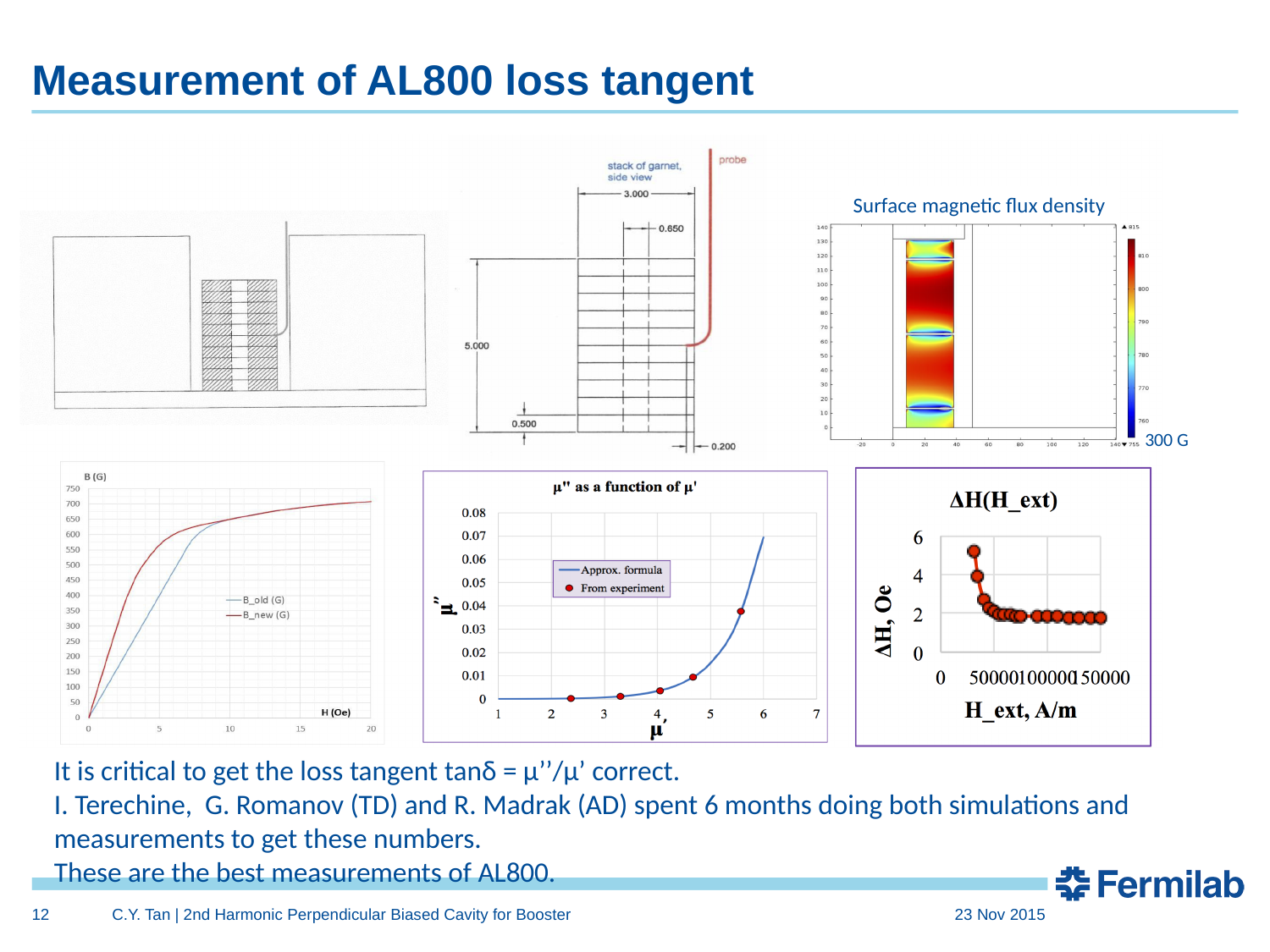
In the B (G) versus H (Oe) chart at the bottom left, what are the two legend entries? B_old (G) and B_new (G) In the chart titled "μ'' as a function of μ'", how many "From experiment" data points are plotted? 5 In the B (G) versus H (Oe) chart at the bottom left, at H = 5 Oe, is the B_old value greater or less than 500? less In the B (G) versus H (Oe) chart at the bottom left, does B rise or fall as H increases? rise In the chart titled "ΔH(H_ext)" at the bottom right, is the ΔH value at H_ext = 100000 A/m greater or less than 4? less In the B (G) versus H (Oe) chart at the bottom left, at H = 20 Oe, is the B_new value greater or less than 650? greater In the B (G) versus H (Oe) chart at the bottom left, at H = 5 Oe, which series has the larger B value, B_old or B_new? B_new In the chart titled "ΔH(H_ext)" at the bottom right, does ΔH rise or fall as H_ext increases? fall In the chart titled "μ'' as a function of μ'", how many entries does the legend list? 2 In the chart titled "μ'' as a function of μ'", does μ'' rise or fall as μ' increases? rise In the B (G) versus H (Oe) chart at the bottom left, how many series does the legend list? 2